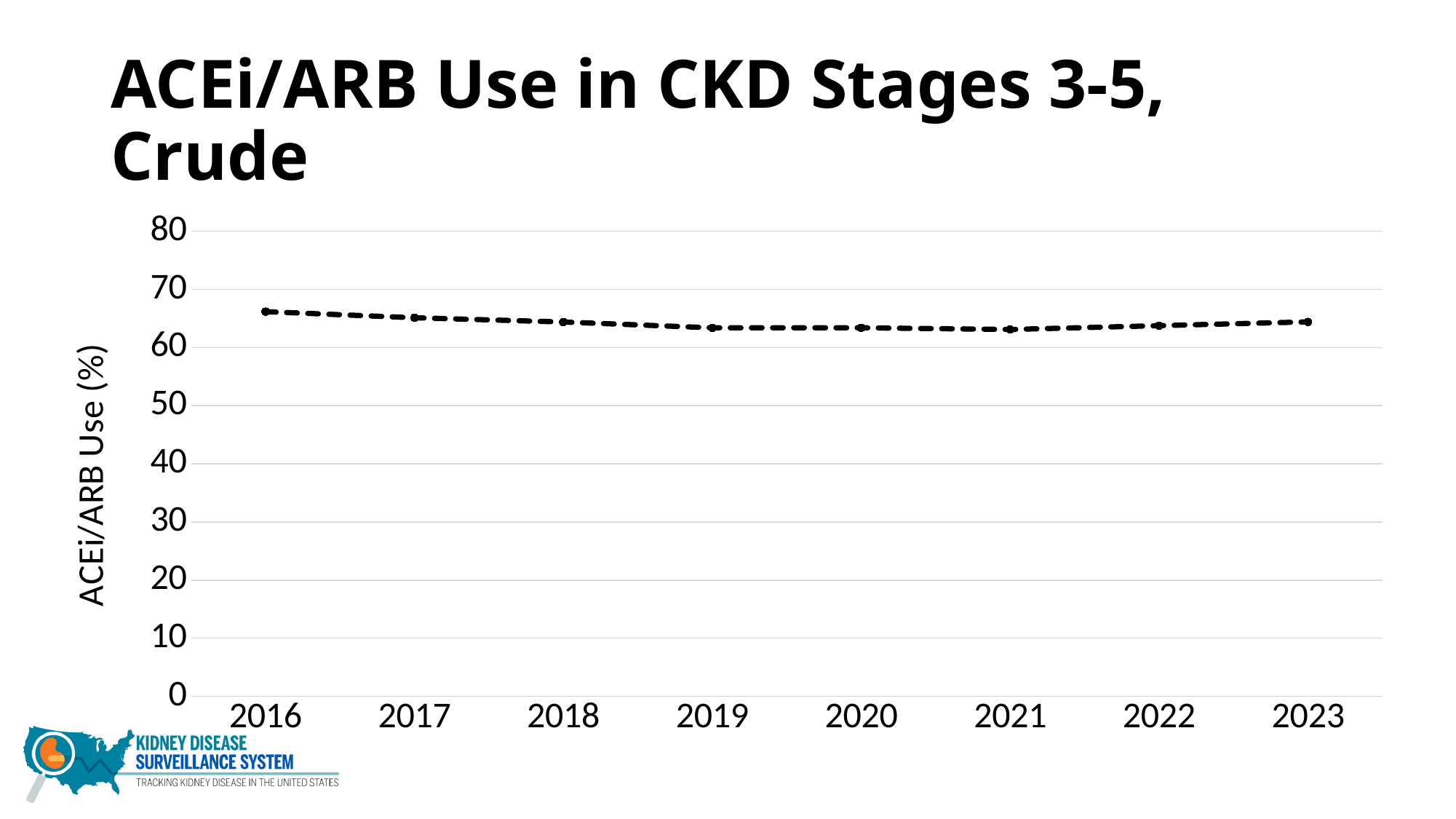
Is the value for 2019 greater or less than 50? greater How many years are plotted along the x axis? 8 Is the value for 2023 greater or less than 60? greater Do the values rise or fall from 2016 to 2021? fall What kind of chart is shown on the slide? Line chart Which is larger, the value for 2016 or the value for 2021? 2016 What is the first year shown on the x axis? 2016 Is the value for 2021 greater or less than 70? less Which year has the highest ACEi/ARB use? 2016 What is the label of the y axis? ACEi/ARB Use (%)